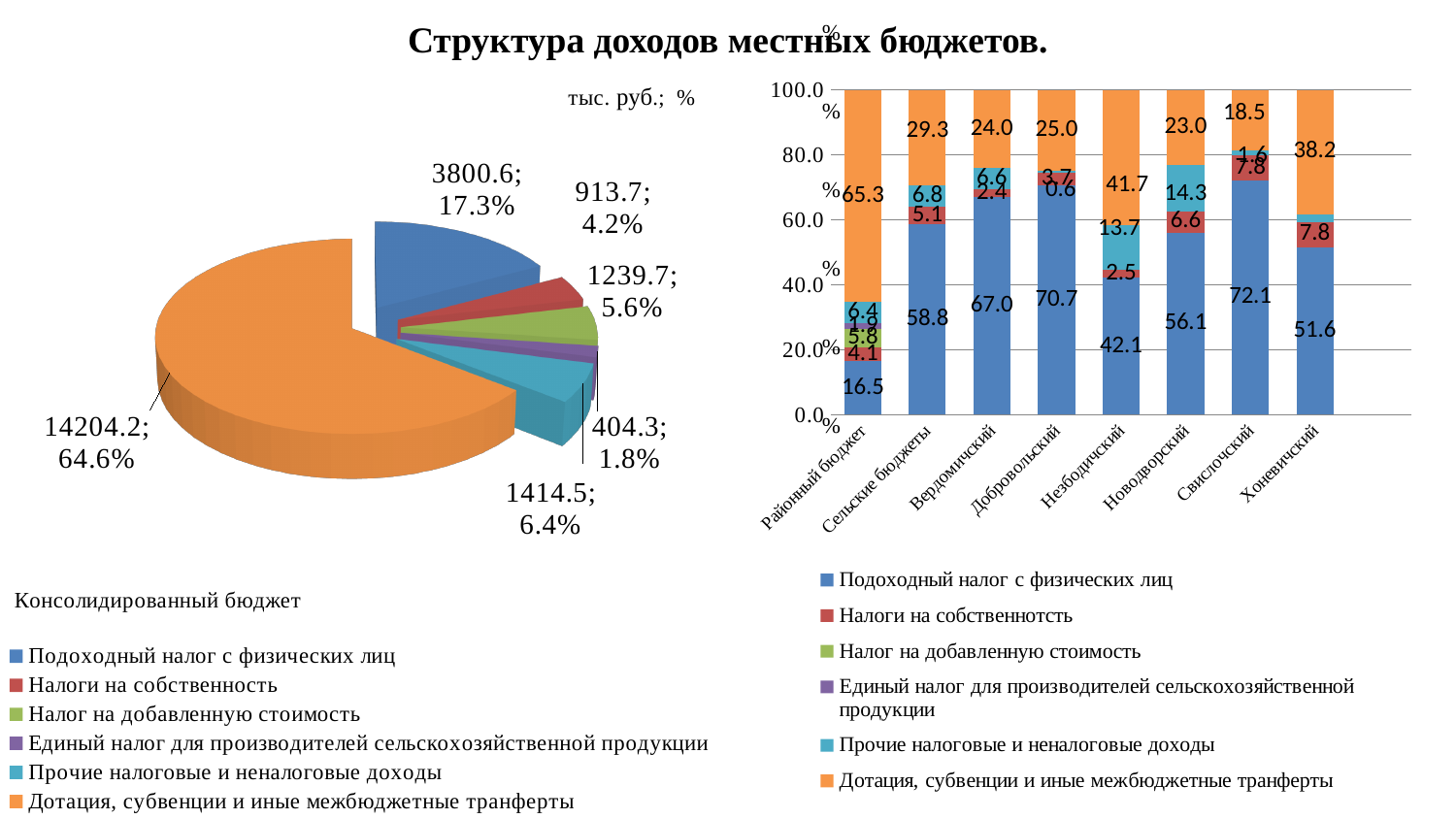
What kind of chart is the chart on the right side of the slide? Stacked bar chart On the stacked bar chart on the right, how many series does the legend list? 6 On the pie chart (Консолидированный бюджет), which category has the smallest slice? Единый налог для производителей сельскохозяйственной продукции On the stacked bar chart on the right, what is the value of Дотация, субвенции и иные межбюджетные трансферты for Районный бюджет? 65.3 On the pie chart (Консолидированный бюджет), what is the value shown for Прочие налоговые и неналоговые доходы? 1414.5; 6.4% On the stacked bar chart on the right, how many categories are shown on the x axis? 8 On the pie chart (Консолидированный бюджет), what value and share are shown for Дотация, субвенции и иные межбюджетные трансферты? 14204.2; 64.6% On the pie chart (Консолидированный бюджет), what share does Подоходный налог с физических лиц have? 17.3% On the stacked bar chart on the right, what is the difference between Дотация, субвенции и иные межбюджетные трансферты for Хоневичский (38.2) and for Свислочский (18.5)? 19.7 On the stacked bar chart on the right, which is larger: Подоходный налог с физических лиц for Незбодичский or for Новодворский? Новодворский On the stacked bar chart on the right, what is the value of Подоходный налог с физических лиц for Свислочский? 72.1 On the pie chart (Консолидированный бюджет), how many slices are there? 6